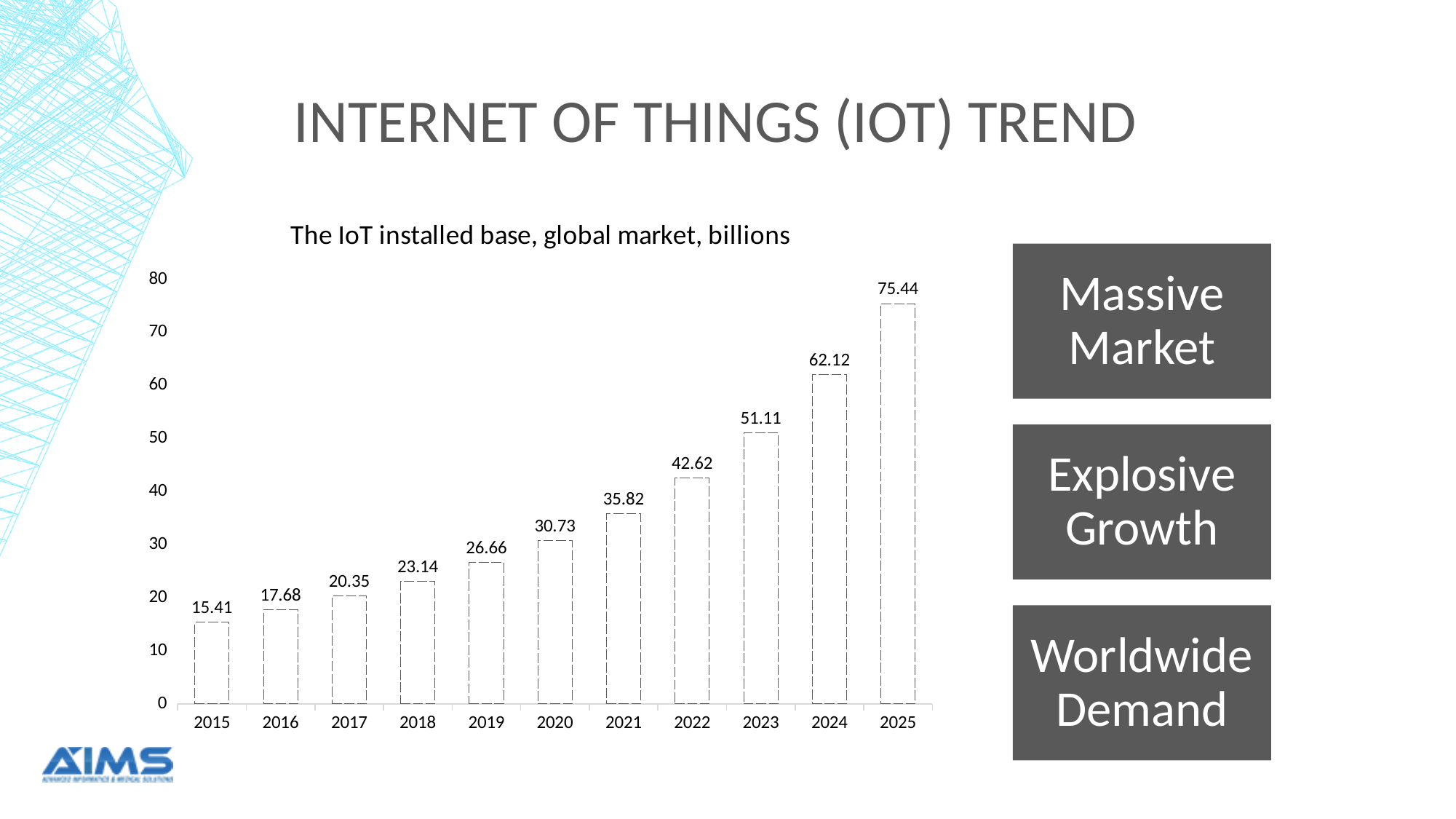
What kind of chart is shown? bar chart Is the value for 2023 greater or less than 50? greater Which is larger, the value for 2022 or the value for 2021? 2022 What is the difference between the values for 2016 and 2015? 2.27 What is the IoT installed base value shown for 2020? 30.73 Which year has the lowest value? 2015 Do the values rise or fall from 2015 to 2025? rise What is the difference between the values for 2025 and 2024? 13.32 What value is shown for 2025? 75.44 What value is shown for 2015? 15.41 Which year has the highest value? 2025 How many years are shown on the x axis? 11